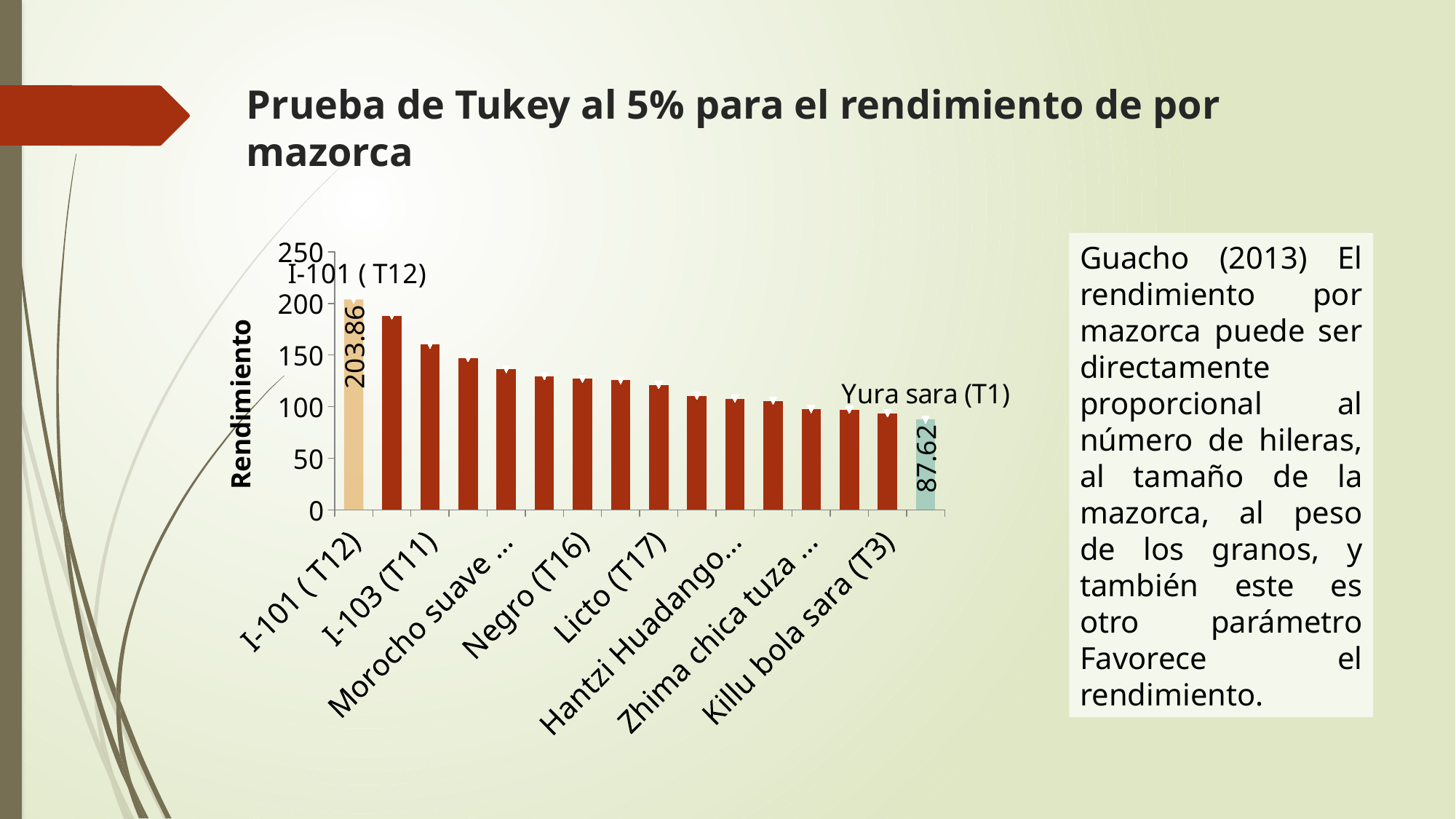
Which is larger, the value for I-103 (T11) or the value for Negro (T16)? I-103 (T11) What is the difference between the values for I-101 (T12) and Yura sara (T1)? 116.24 Which category has the highest value? I-101 (T12) What kind of chart is shown on the slide? bar chart Do the values rise or fall from left to right along the x axis? fall What is the value for Yura sara (T1)? 87.62 What is the value for I-101 (T12)? 203.86 How many bars are plotted in the chart? 16 Is the value for Negro (T16) greater or less than 150? less Which category has the lowest value? Yura sara (T1) Is the value for Licto (T17) greater or less than 100? greater Is the value for I-103 (T11) greater or less than 150? greater